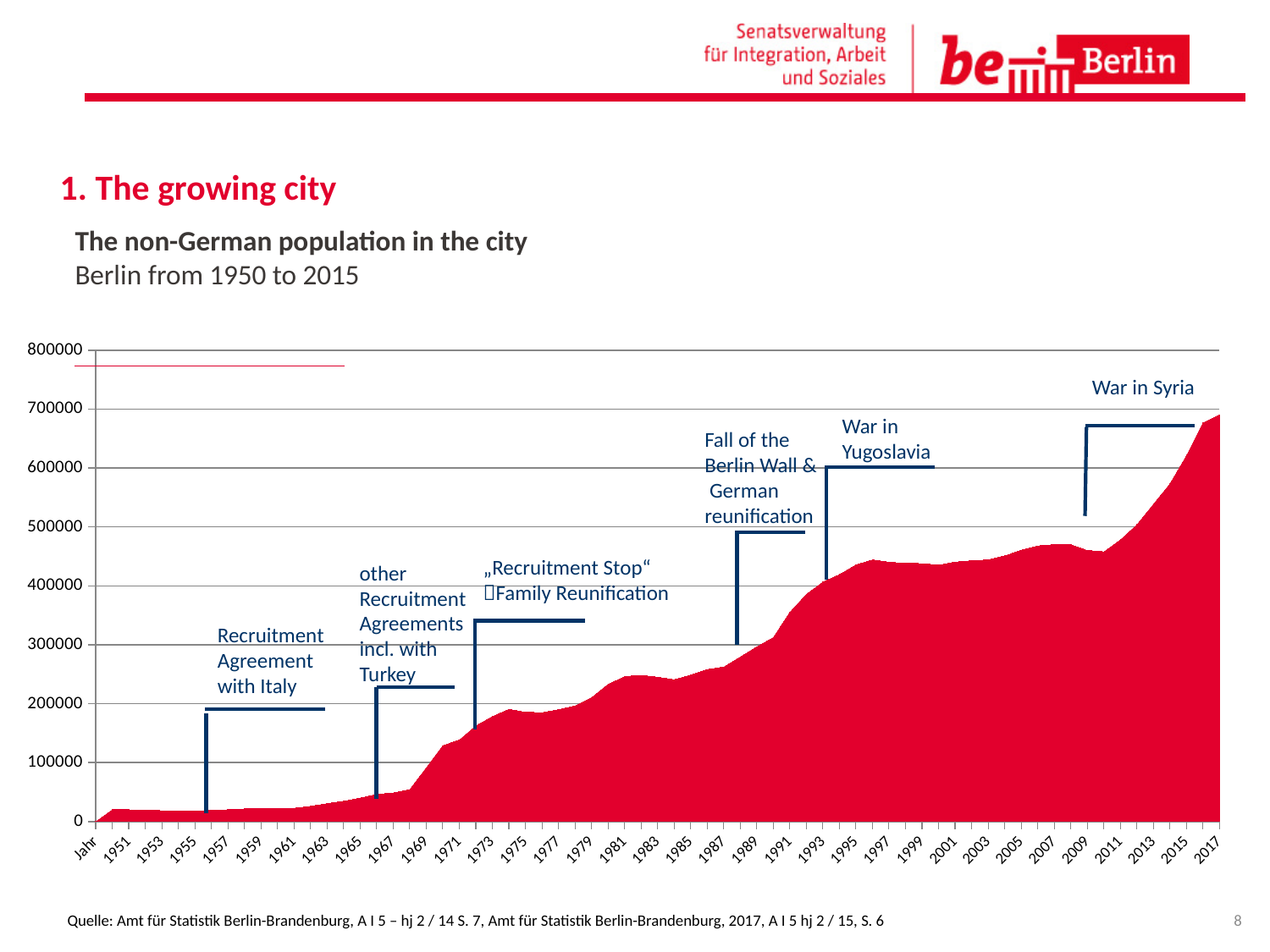
What is the title of the chart? The non-German population in the city Is the value for 1961 greater or less than 100000? less Which year has the larger value, 1981 or 1997? 1997 What kind of chart is shown on the slide? area chart Which event is annotated at the far right of the chart, near 2015? War in Syria Do the values generally rise or fall from 1951 to 2017? rise Is the value for 1971 greater or less than 200000? less Which year shows the highest non-German population? 2017 Is the value for 1989 greater or less than 400000? less